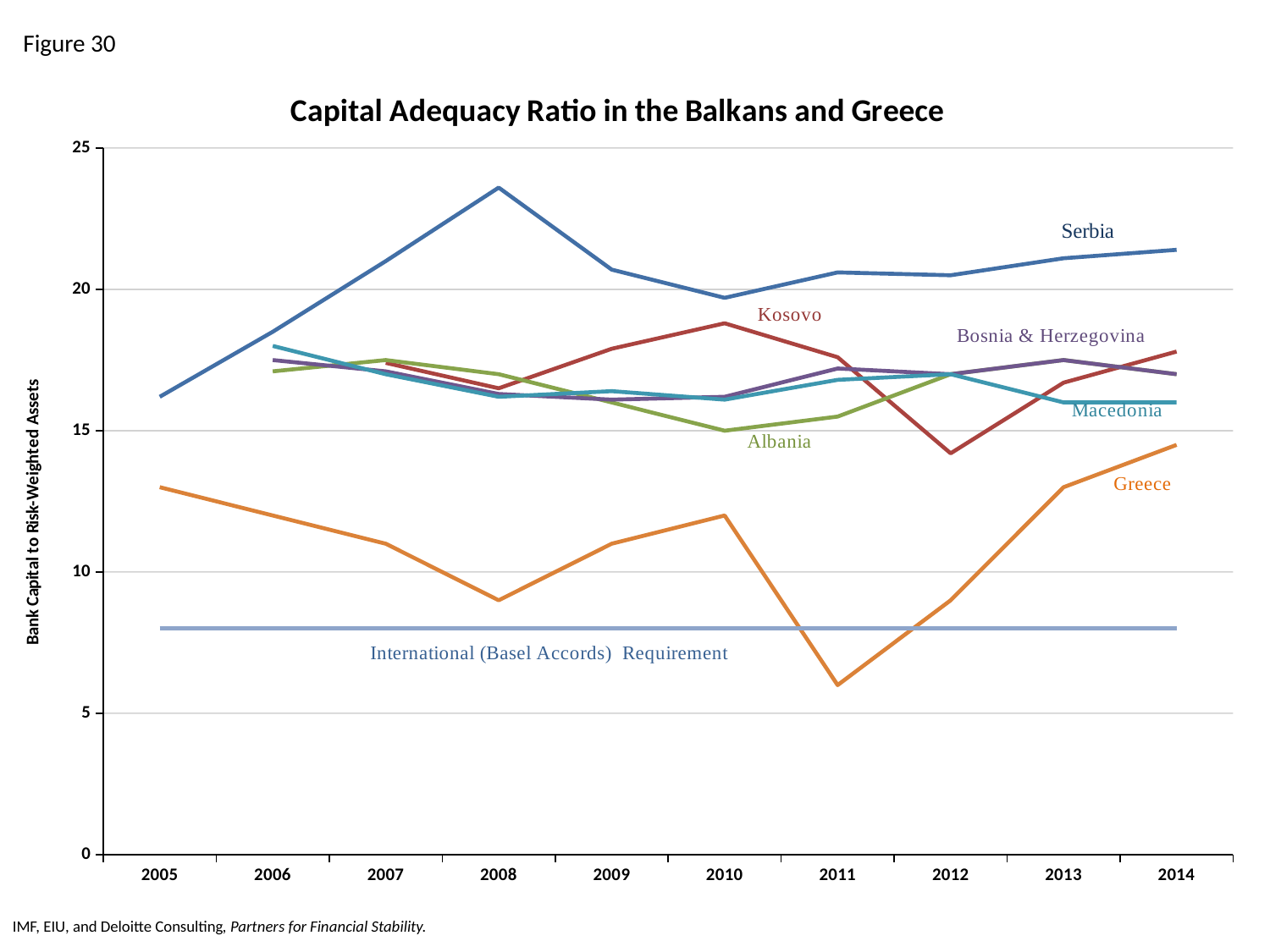
Is the value for Kosovo in 2012 greater or less than 15? less How many countries have lines plotted on the chart? 6 Which is larger in 2011, the value for Greece or the International (Basel Accords) Requirement? International (Basel Accords) Requirement Which is larger in 2010, the value for Serbia or the value for Kosovo? Serbia What is the title of the y axis? Bank Capital to Risk-Weighted Assets Does the value for Greece rise or fall from 2011 to 2014? rise What kind of chart is shown on the slide? line chart Is the value for Serbia in 2008 greater or less than 20? greater Which country has the lowest capital adequacy ratio in 2011? Greece Is the value for Greece in 2011 greater or less than 10? less How many years are shown on the x axis? 10 Which country has the highest capital adequacy ratio in 2014? Serbia